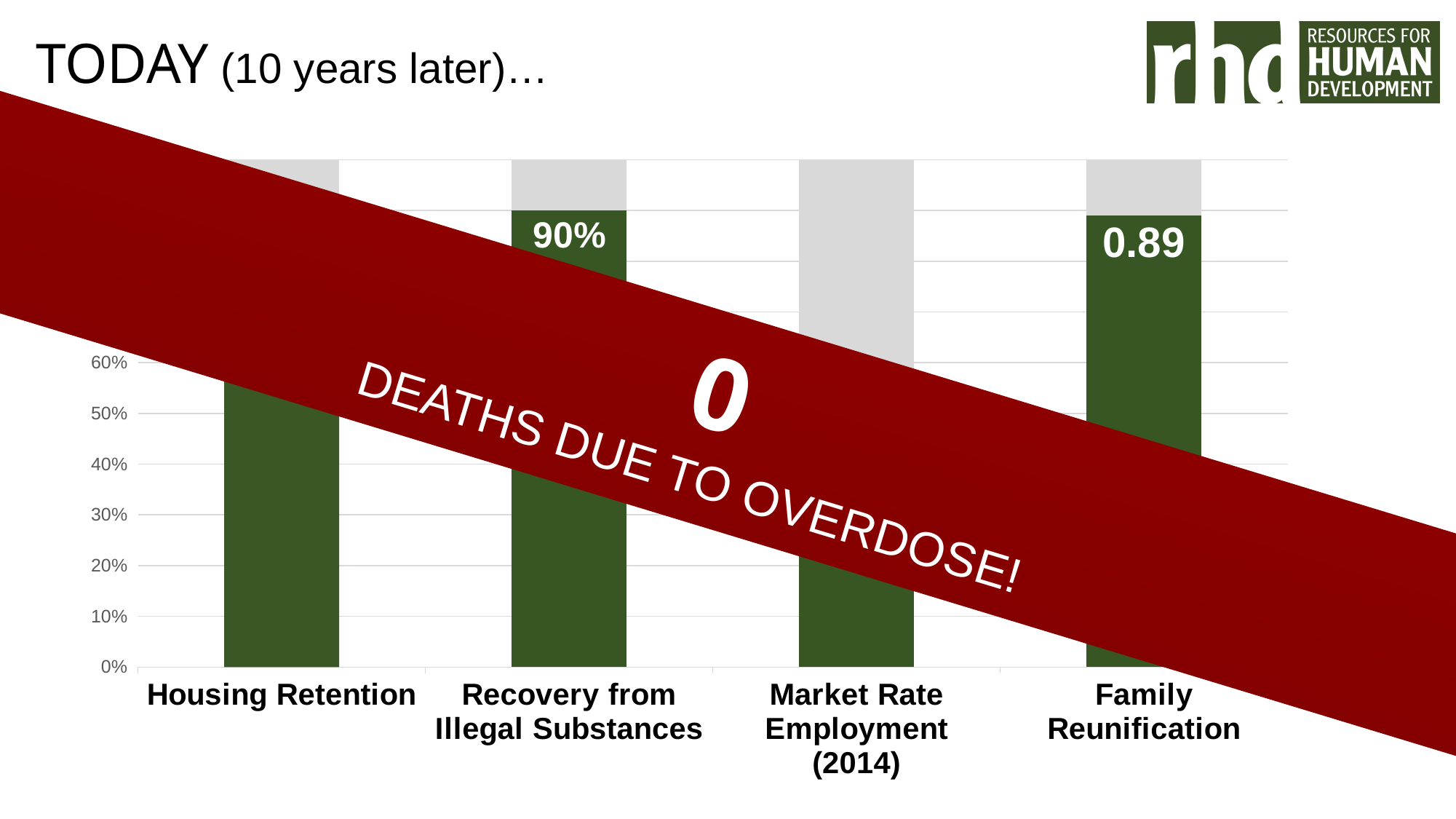
Is the value for Market Rate Employment (2014) greater or less than 70%? less What does the red banner across the chart say? 0 DEATHS DUE TO OVERDOSE! What is the value shown for Family Reunification? 0.89 What is the value shown for Recovery from Illegal Substances? 90% What is the title of the slide containing the chart? TODAY (10 years later)… Is the value for Market Rate Employment (2014) greater or less than 10%? greater What kind of chart is shown on the slide? bar chart Is the value for Housing Retention greater or less than 50%? greater Which is larger, the value for Recovery from Illegal Substances or the value for Family Reunification? Recovery from Illegal Substances How many categories are shown on the x axis of the chart? 4